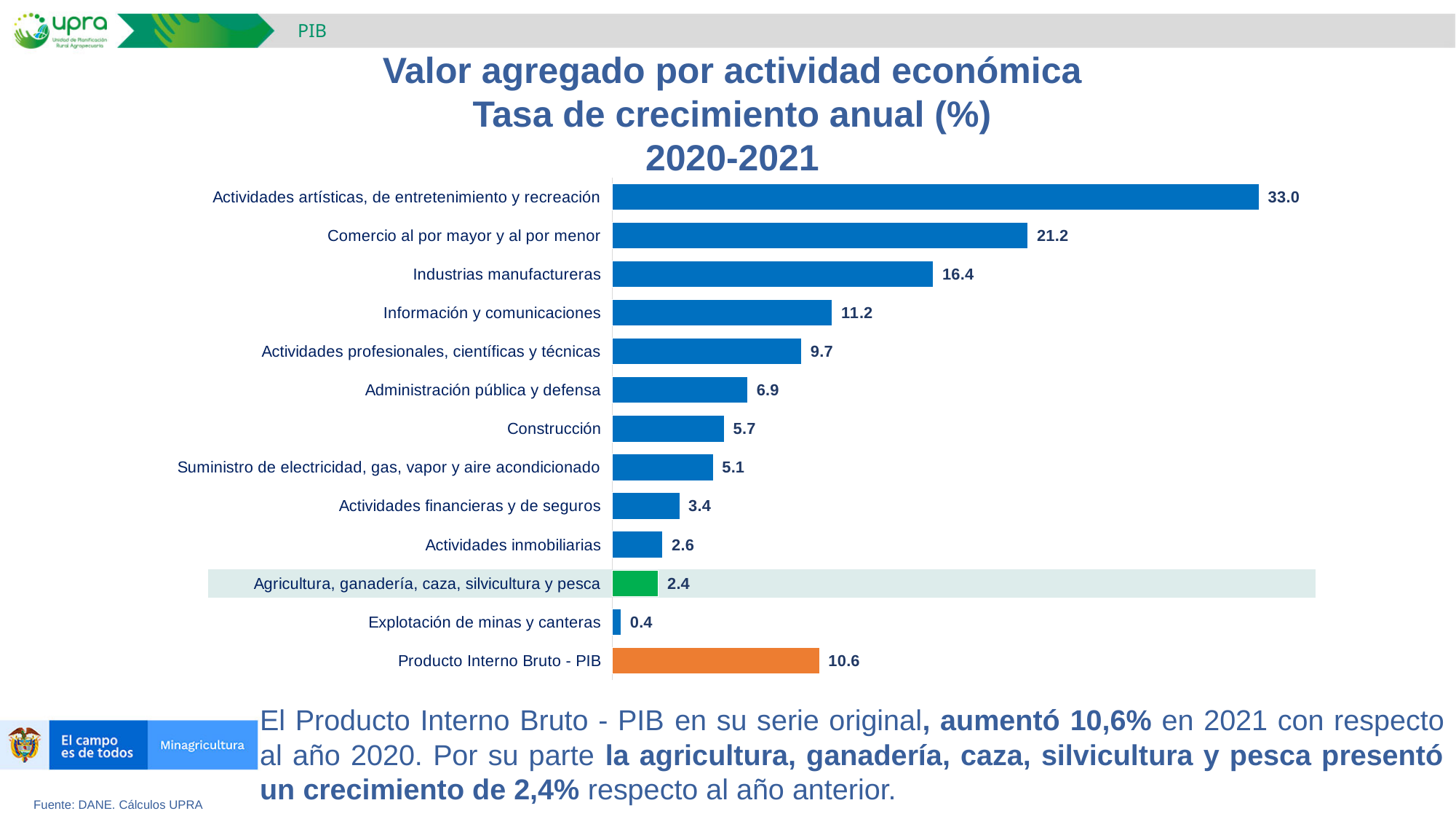
What colour is the bar for Agricultura, ganadería, caza, silvicultura y pesca? Green What is the difference between the growth rates of Comercio al por mayor y al por menor and Información y comunicaciones? 10.0 Which economic activity has the highest growth rate on the chart? Actividades artísticas, de entretenimiento y recreación Which economic activity has the lowest growth rate on the chart? Explotación de minas y canteras What kind of chart is shown on the slide? Bar chart What is the annual growth rate shown for Actividades artísticas, de entretenimiento y recreación? 33.0 What is the value shown for Producto Interno Bruto - PIB? 10.6 What is the value shown for Industrias manufactureras? 16.4 Which has a higher growth rate, Construcción or Administración pública y defensa? Administración pública y defensa What is the value shown for Agricultura, ganadería, caza, silvicultura y pesca? 2.4 What colour is the bar for Producto Interno Bruto - PIB? Orange How many bars are plotted on the chart? 13